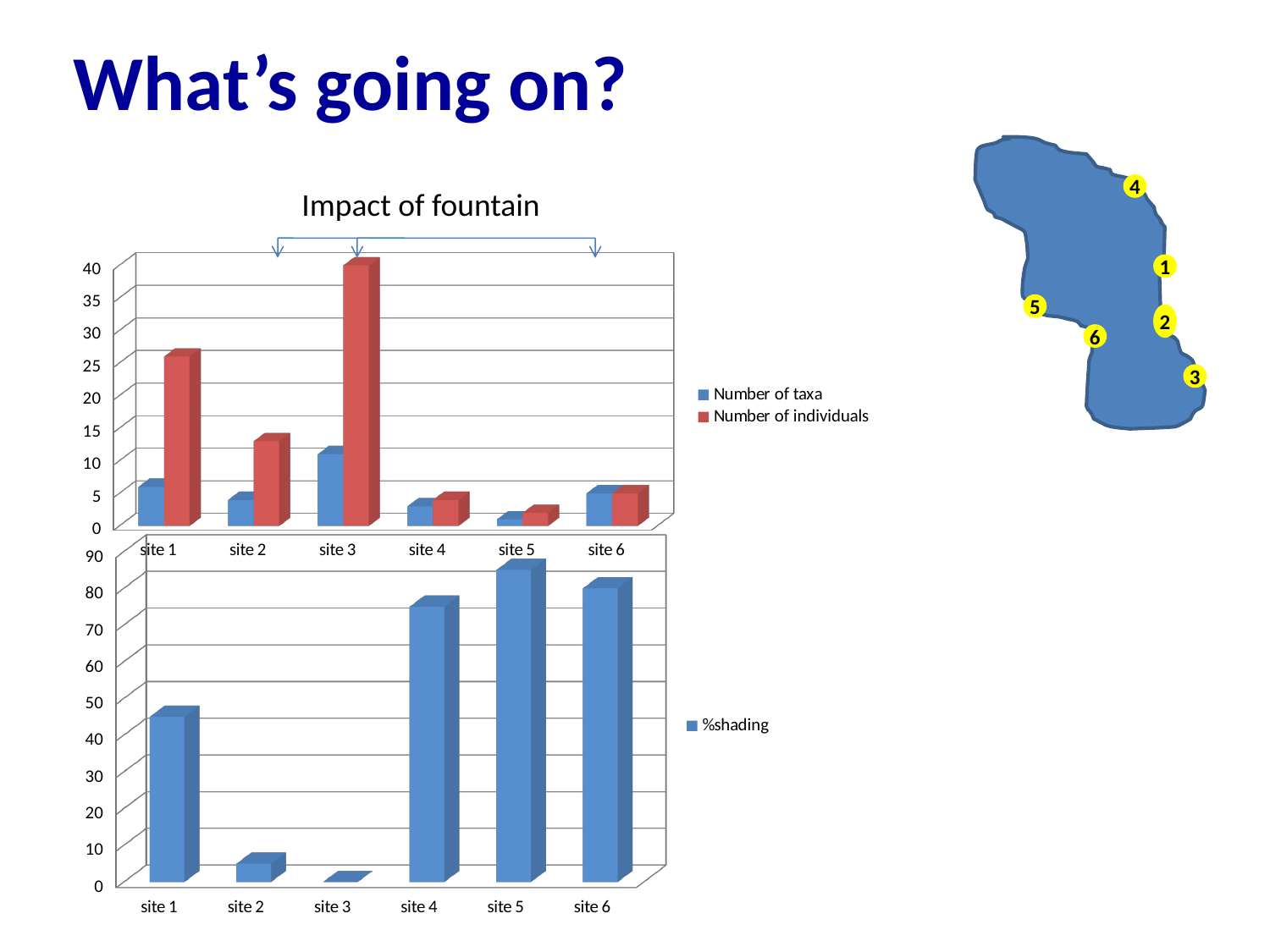
In the bottom chart, which site has the lowest %shading? site 3 In the bottom chart, which site has the highest %shading? site 5 In the top chart 'Impact of fountain', is the Number of individuals for site 3 greater or less than 35? greater In the top chart 'Impact of fountain', how many series does the legend list? 2 In the top chart 'Impact of fountain', is the Number of individuals for site 1 greater or less than 20? greater In the top chart 'Impact of fountain', which site has the highest Number of individuals? site 3 In the top chart 'Impact of fountain', which site has the lowest Number of individuals? site 5 In the bottom chart, is the %shading for site 1 greater or less than 40? greater In the top chart 'Impact of fountain', how many sites are shown on the x axis? 6 In the top chart 'Impact of fountain', which site has the highest Number of taxa? site 3 What is the title of the top chart? Impact of fountain What kind of chart is the bottom chart showing %shading? bar chart